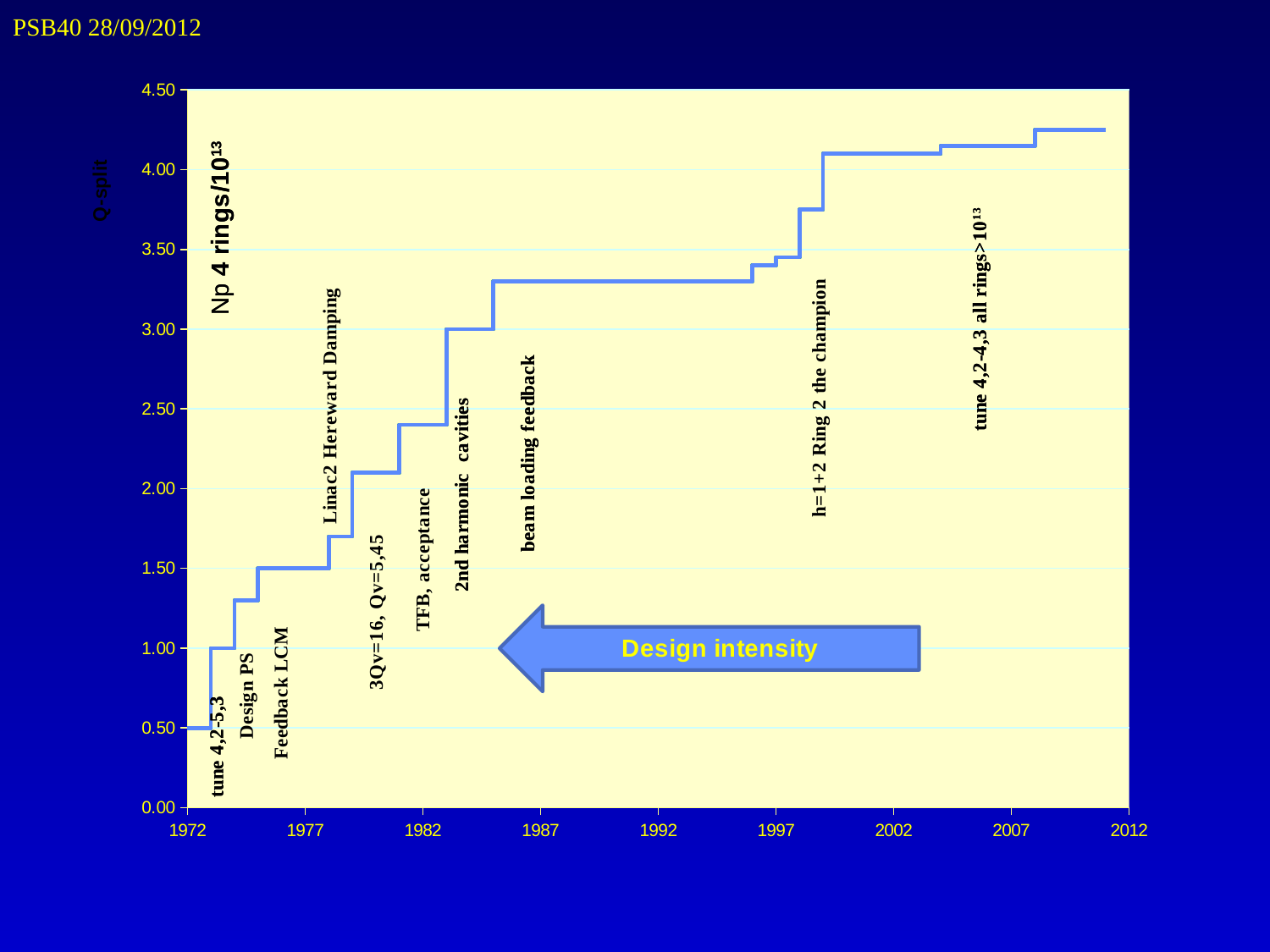
Is the plotted value in 2010 greater or less than 4.00? greater What is the plotted value at the start of the chart in 1972? 0.50 Is the plotted value in 1995 greater or less than 3.00? greater What is the plotted value in 1984? 3.00 What kind of chart is shown on the slide? Line chart Is the plotted value in 1980 greater or less than 2.50? less What text is written inside the large arrow on the chart? Design intensity Does the plotted value rise or fall as the years increase from 1972 to 2012? Rise Which is larger, the plotted value in 1985 or the plotted value in 2000? 2000 How many year labels are shown on the x axis? 9 What is the plotted value in 1976? 1.50